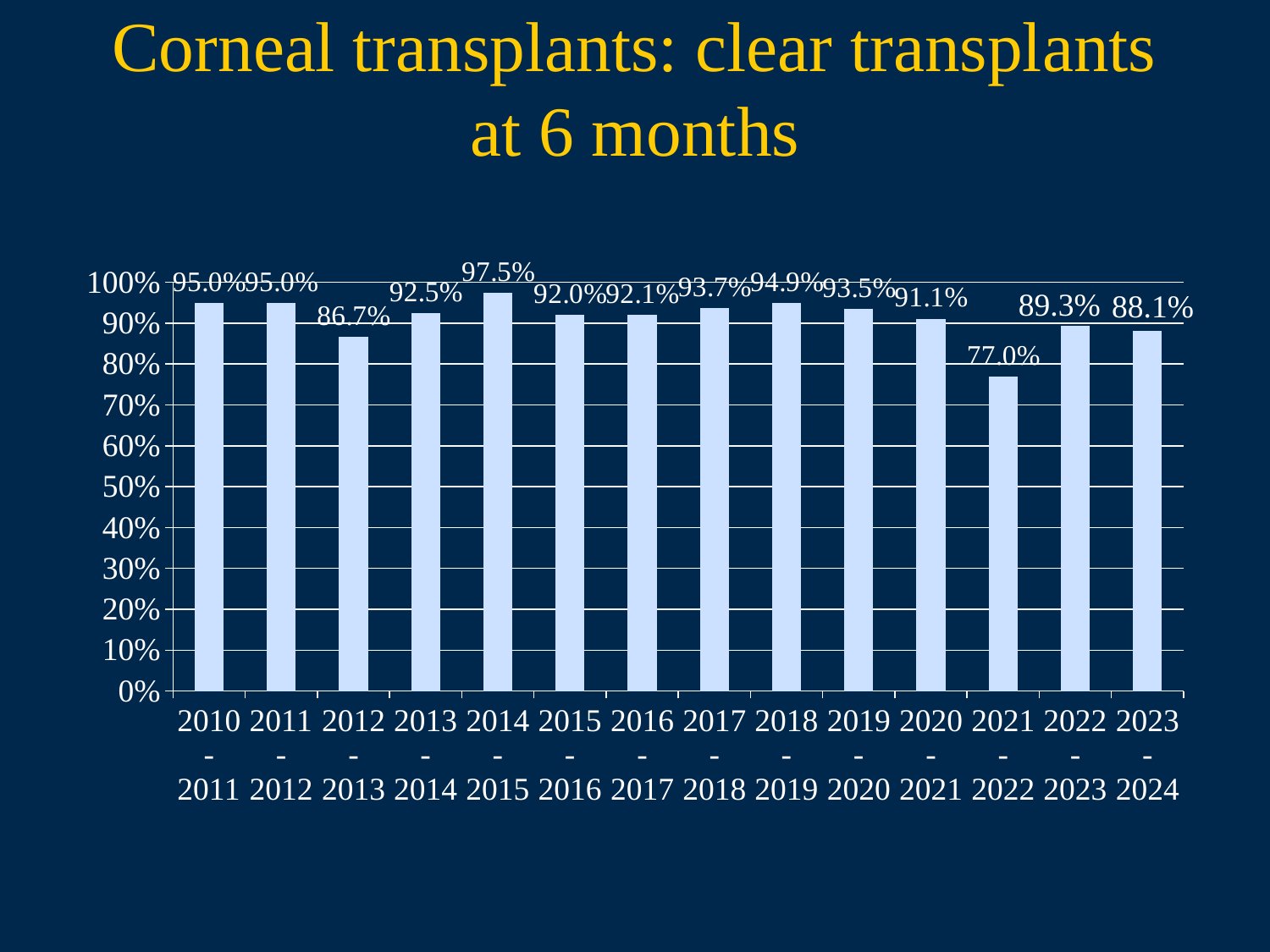
How many periods are shown on the x axis? 14 What is the value for 2014-2015? 97.5% What is the title of the chart? Corneal transplants: clear transplants at 6 months Is the value for 2021-2022 greater or less than 80%? less What kind of chart is shown on the slide? bar chart What is the value for 2023-2024? 88.1% Which period has the lowest value? 2021-2022 What is the value for 2021-2022? 77.0% What is the value for 2012-2013? 86.7% What is the difference between the values for 2014-2015 and 2021-2022? 20.5% Which is larger, the value for 2018-2019 or the value for 2020-2021? 2018-2019 Which period has the highest value? 2014-2015